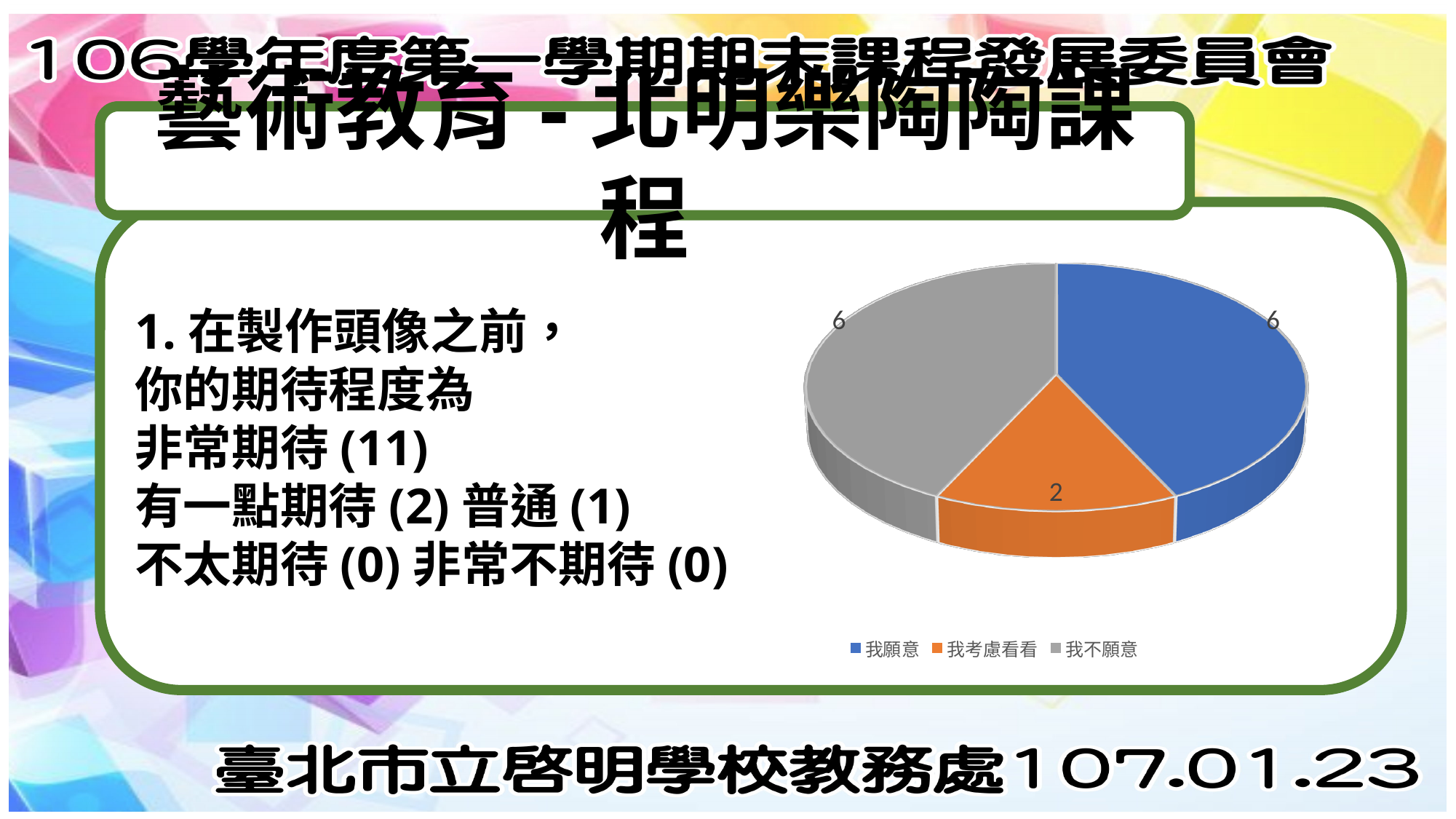
What is the total of all the values shown in the pie chart? 14 What colour is the 我考慮看看 slice in the pie chart? orange What colour is the 我不願意 slice in the pie chart? gray What is the difference between the values for 我不願意 and 我考慮看看 in the pie chart? 4 How many slices does the pie chart have? 3 How many entries does the legend of the pie chart list? 3 Which is larger in the pie chart, 我願意 or 我考慮看看? 我願意 Which category has the smallest slice in the pie chart? 我考慮看看 What kind of chart is shown on the slide? pie chart What is the value for 我願意 in the pie chart? 6 What is the value for 我不願意 in the pie chart? 6 What is the value for 我考慮看看 in the pie chart? 2